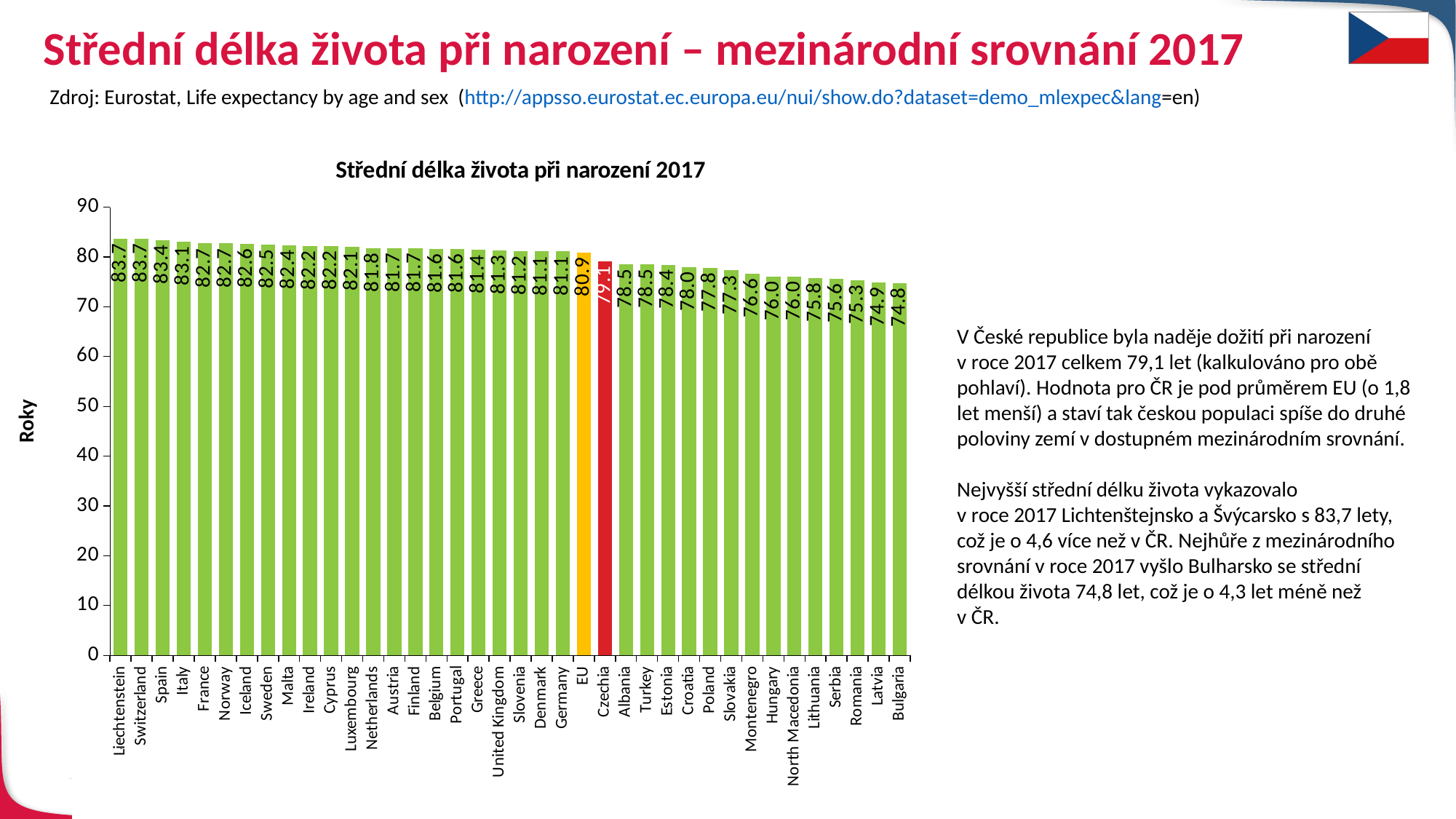
What is the value shown for Spain? 83.4 Which has a higher value, Hungary or Slovakia? Slovakia What type of chart is shown on the slide? bar chart Which country has the lowest value in the chart? Bulgaria What is the difference between the values for Liechtenstein and Czechia? 4.6 What is the life expectancy value shown for Czechia? 79.1 What value is shown for the EU bar? 80.9 What is the difference between the EU value and the Czechia value? 1.8 Is the value for Romania greater or less than 80? less What colour is the bar for Czechia? red How many bars (countries plus EU) are shown in the chart? 38 What is the value shown for Poland? 77.8